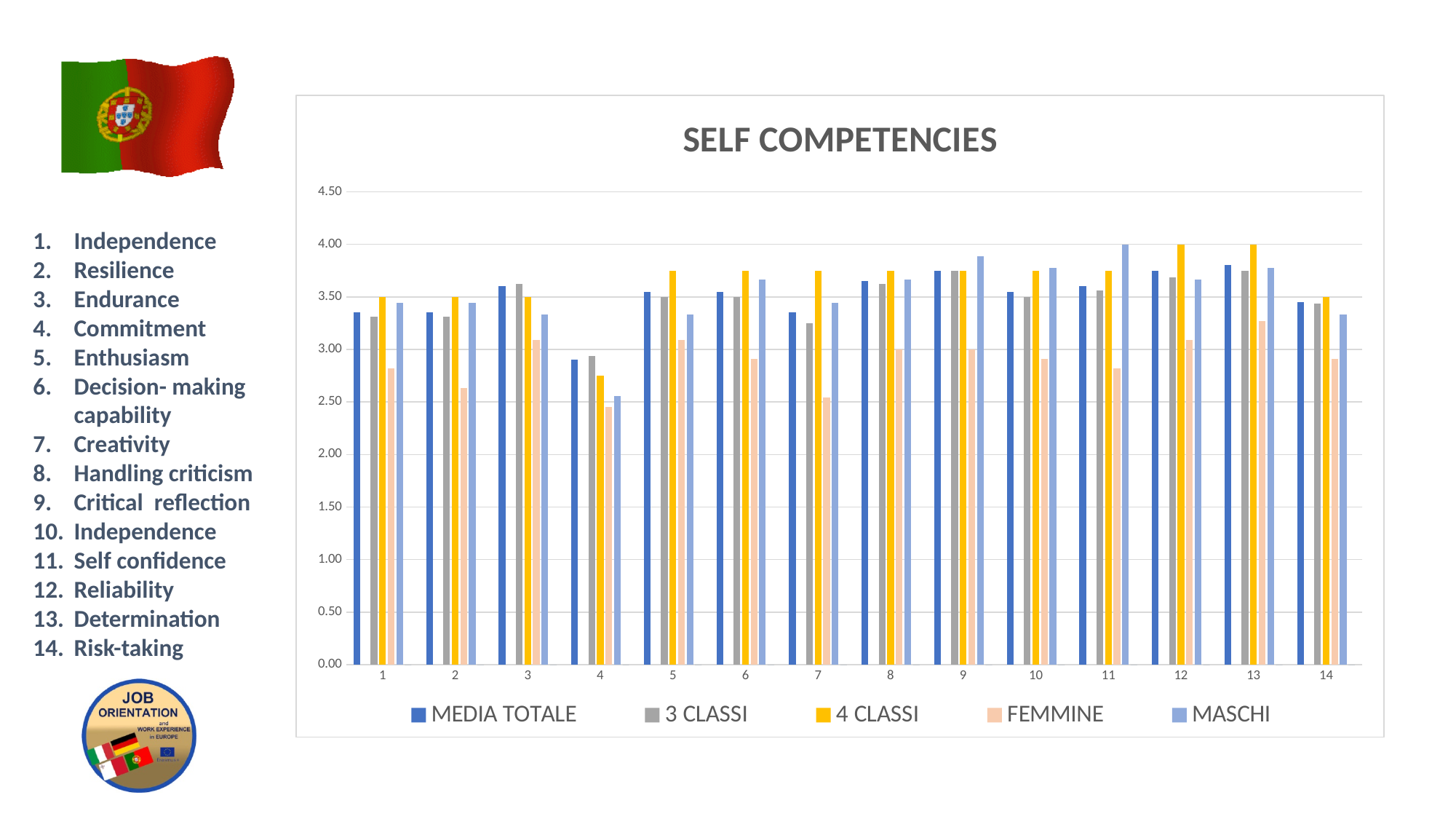
How many series does the chart legend list? 5 For category 1, which is larger: the FEMMINE value or the MASCHI value? MASCHI Which series is shown in yellow in the chart legend? 4 CLASSI Is the MEDIA TOTALE value for category 4 greater or less than 3.00? less Which category has the lowest FEMMINE value? 4 Is the FEMMINE value for category 4 greater or less than 2.50? less How many categories are shown along the x axis of the chart? 14 What is the title of the chart? SELF COMPETENCIES Which category has the lowest MEDIA TOTALE value? 4 Which category has the highest MASCHI value? 11 Is the MASCHI value for category 9 greater or less than 3.50? greater What kind of chart is shown on the slide? bar chart